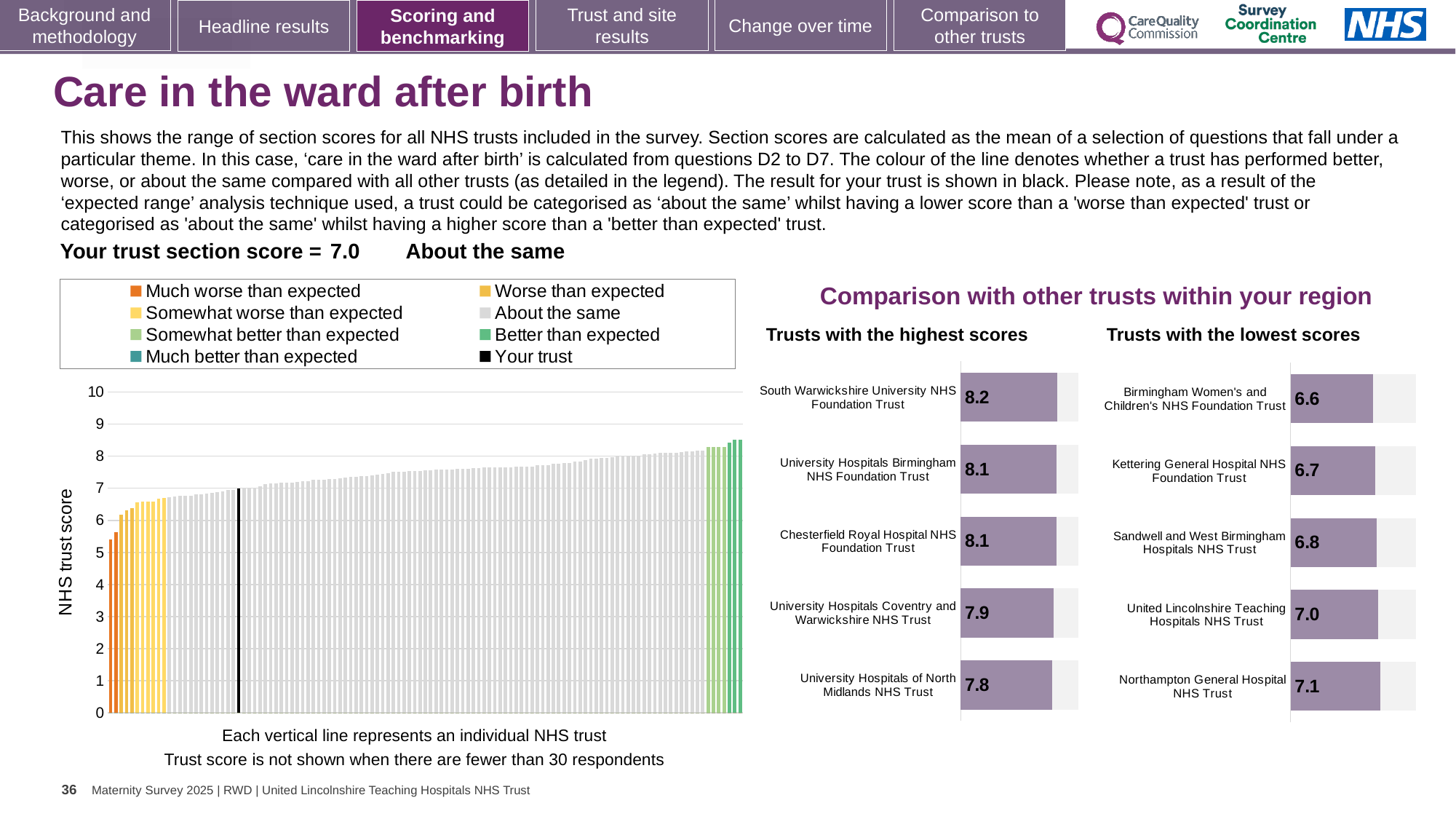
How many entries does the legend of the large chart on the left list? 8 How many trusts are shown in the 'Trusts with the lowest scores' chart? 5 In the 'Trusts with the lowest scores' chart, what is the score for Kettering General Hospital NHS Foundation Trust? 6.7 In the 'Trusts with the highest scores' chart, what is the difference between the scores of South Warwickshire University NHS Foundation Trust and University Hospitals of North Midlands NHS Trust? 0.4 In the large chart on the left, do the trust scores rise or fall from left to right? Rise In the 'Trusts with the highest scores' chart, what is the score for South Warwickshire University NHS Foundation Trust? 8.2 In the 'Trusts with the lowest scores' chart, which has the higher score: Sandwell and West Birmingham Hospitals NHS Trust or Kettering General Hospital NHS Foundation Trust? Sandwell and West Birmingham Hospitals NHS Trust In the 'Trusts with the lowest scores' chart, which trust has the lowest score? Birmingham Women's and Children's NHS Foundation Trust In the 'Trusts with the lowest scores' chart, what is the difference between the scores of Northampton General Hospital NHS Trust and Birmingham Women's and Children's NHS Foundation Trust? 0.5 In the 'Trusts with the highest scores' chart, what is the score for University Hospitals of North Midlands NHS Trust? 7.8 In the 'Trusts with the highest scores' chart, which trust has the highest score? South Warwickshire University NHS Foundation Trust What kind of chart is the large chart on the left showing NHS trust scores? Bar chart